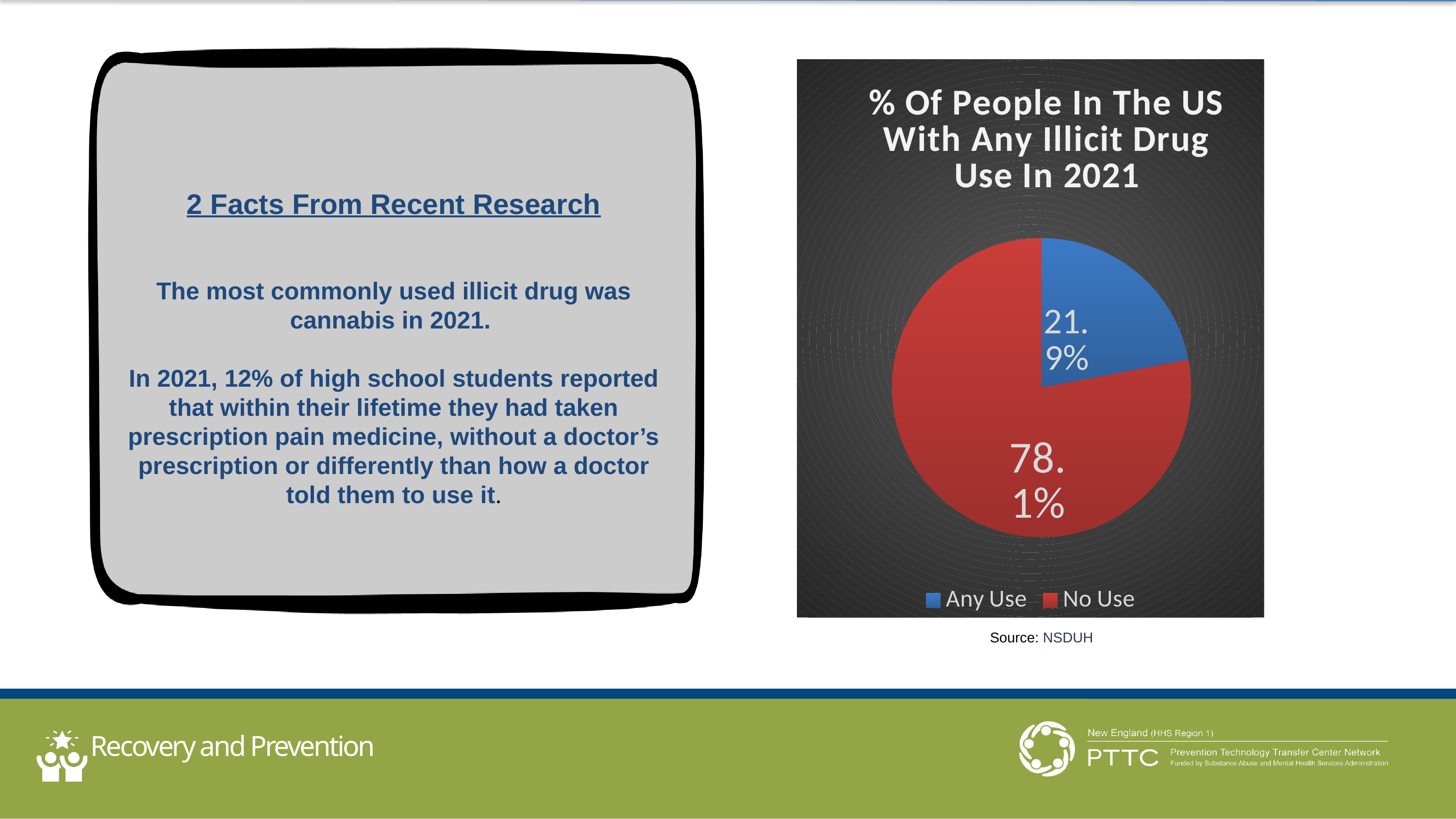
How many entries does the chart legend list? 2 What kind of chart is shown on the slide? Pie chart What colour is the No Use slice in the pie chart? Red How many slices does the pie chart have? 2 What share of the pie does the Any Use slice represent? 21.9% Which is larger, the Any Use slice or the No Use slice? No Use What is the title of the pie chart? % Of People In The US With Any Illicit Drug Use In 2021 Which slice of the pie chart is the smallest? Any Use What is the difference in percentage points between the No Use and Any Use slices? 56.2 What percentage of people in the US had no illicit drug use in 2021 according to the pie chart? 78.1% Which slice of the pie chart is the largest? No Use What percentage of people in the US had any illicit drug use in 2021 according to the pie chart? 21.9%